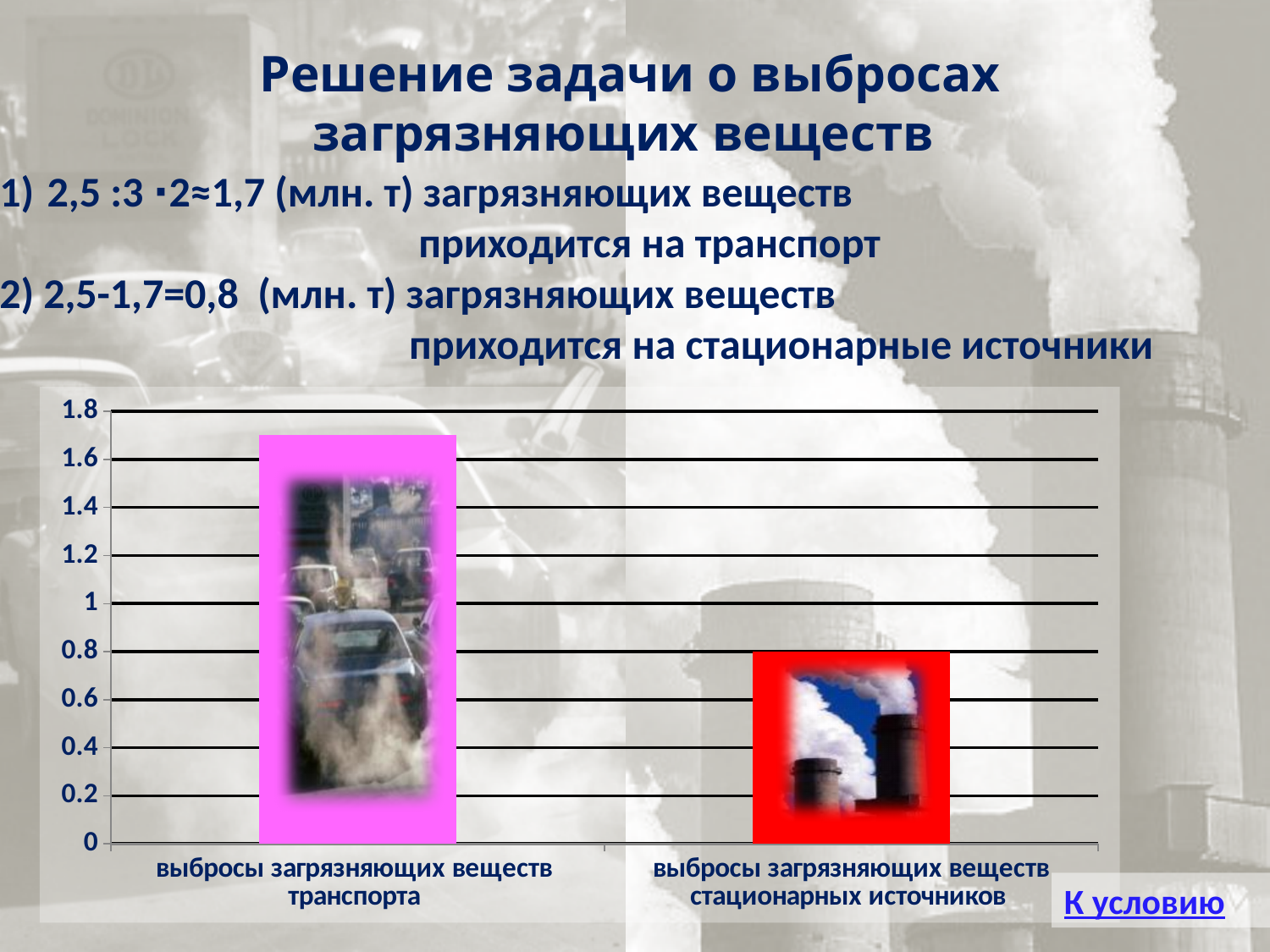
Do the bar values rise or fall from left to right along the x axis? fall What colour is the bar for выбросы загрязняющих веществ стационарных источников? red Is the value for выбросы загрязняющих веществ стационарных источников greater or less than 0.6? greater Which category has the highest bar? выбросы загрязняющих веществ транспорта Is the value for выбросы загрязняющих веществ транспорта greater or less than 1.8? less Which category has the lowest bar? выбросы загрязняющих веществ стационарных источников What kind of chart is shown on the slide? bar chart Which is larger: the bar for выбросы загрязняющих веществ транспорта or the bar for выбросы загрязняющих веществ стационарных источников? выбросы загрязняющих веществ транспорта Is the value for выбросы загрязняющих веществ стационарных источников greater or less than 1? less What is the highest value shown on the vertical axis of the chart? 1.8 How many bars does the chart have? 2